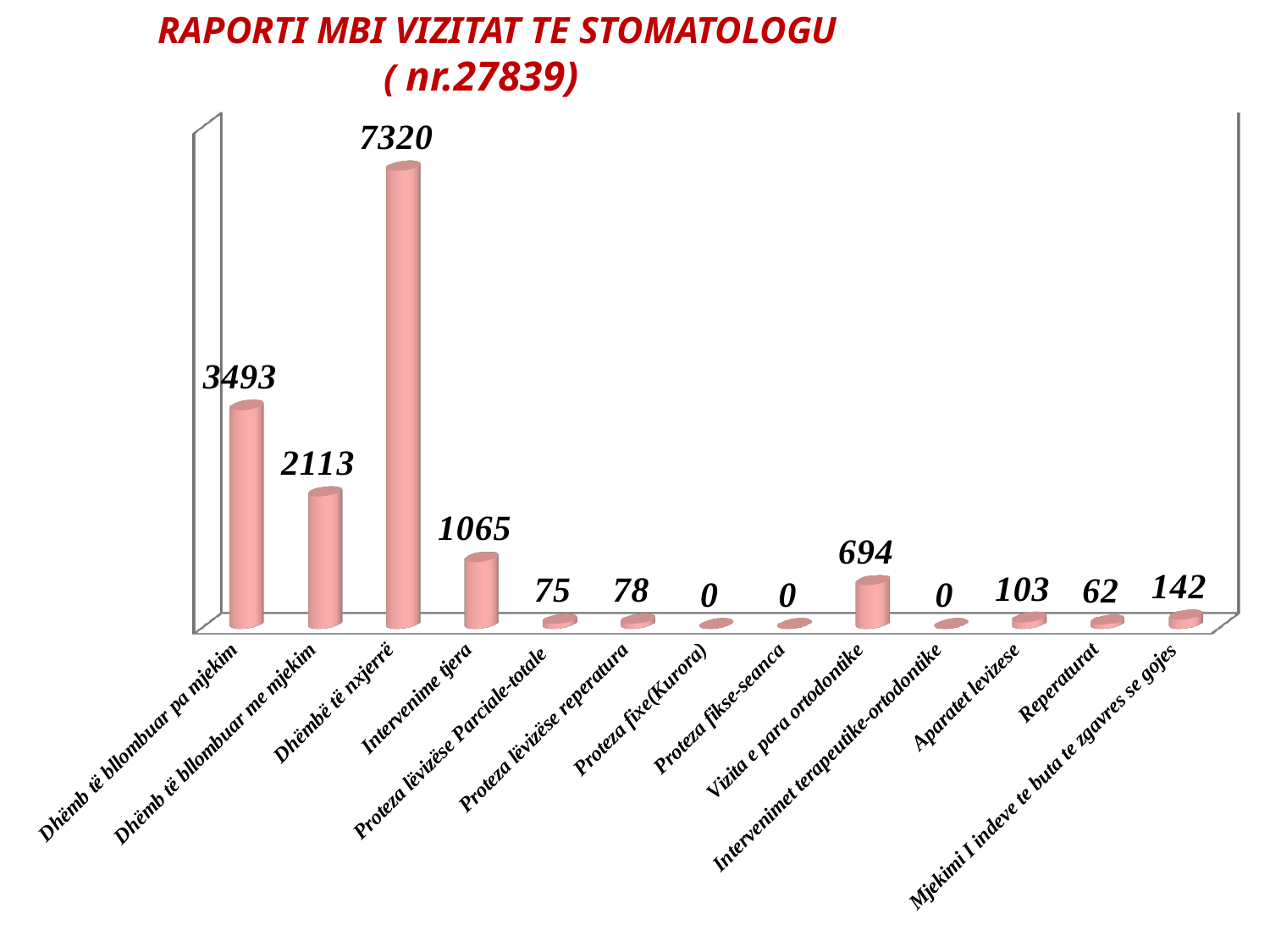
What number is shown in parentheses in the chart title? nr.27839 What is the value for Dhëmbë të nxjerrë? 7320 What is the value for Mjekimi I indeve te buta te zgavres se gojes? 142 What is the value for Dhëmb të bllombuar pa mjekim? 3493 Which is larger, the value for Aparatet levizese or the value for Reperaturat? Aparatet levizese What is the difference between the values for Dhëmb të bllombuar pa mjekim and Dhëmb të bllombuar me mjekim? 1380 What kind of chart is shown on the slide? Bar chart How many categories have a value of 0? 3 Which category has the highest value? Dhëmbë të nxjerrë What is the difference between the values for Dhëmbë të nxjerrë and Intervenime tjera? 6255 How many categories are shown on the x axis? 13 What is the value for Vizita e para ortodontike? 694